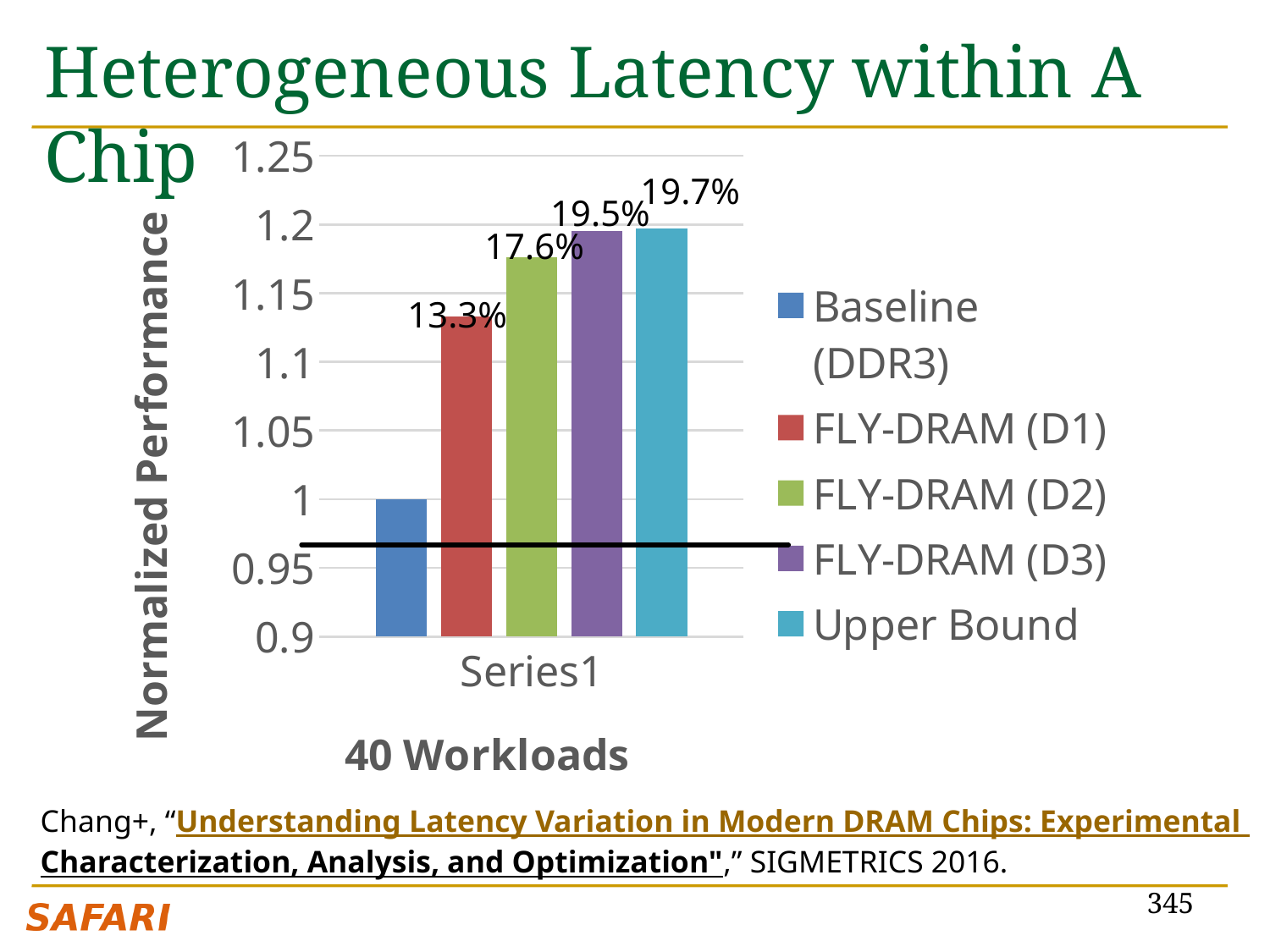
What kind of chart is shown on the slide? bar chart Is the normalized performance for FLY-DRAM (D1) greater or less than 1.15? less What percentage label is printed above the FLY-DRAM (D1) bar? 13.3% How many series does the legend list? 5 What percentage label is printed above the Upper Bound bar? 19.7% Which series has the lowest normalized performance? Baseline (DDR3) What percentage label is printed above the FLY-DRAM (D3) bar? 19.5% What percentage label is printed above the FLY-DRAM (D2) bar? 17.6% What is the title of the y axis? Normalized Performance Which bar is taller, FLY-DRAM (D1) or FLY-DRAM (D2)? FLY-DRAM (D2) How many categories are shown on the x axis? 1 What is the normalized performance value of the Baseline (DDR3) bar? 1